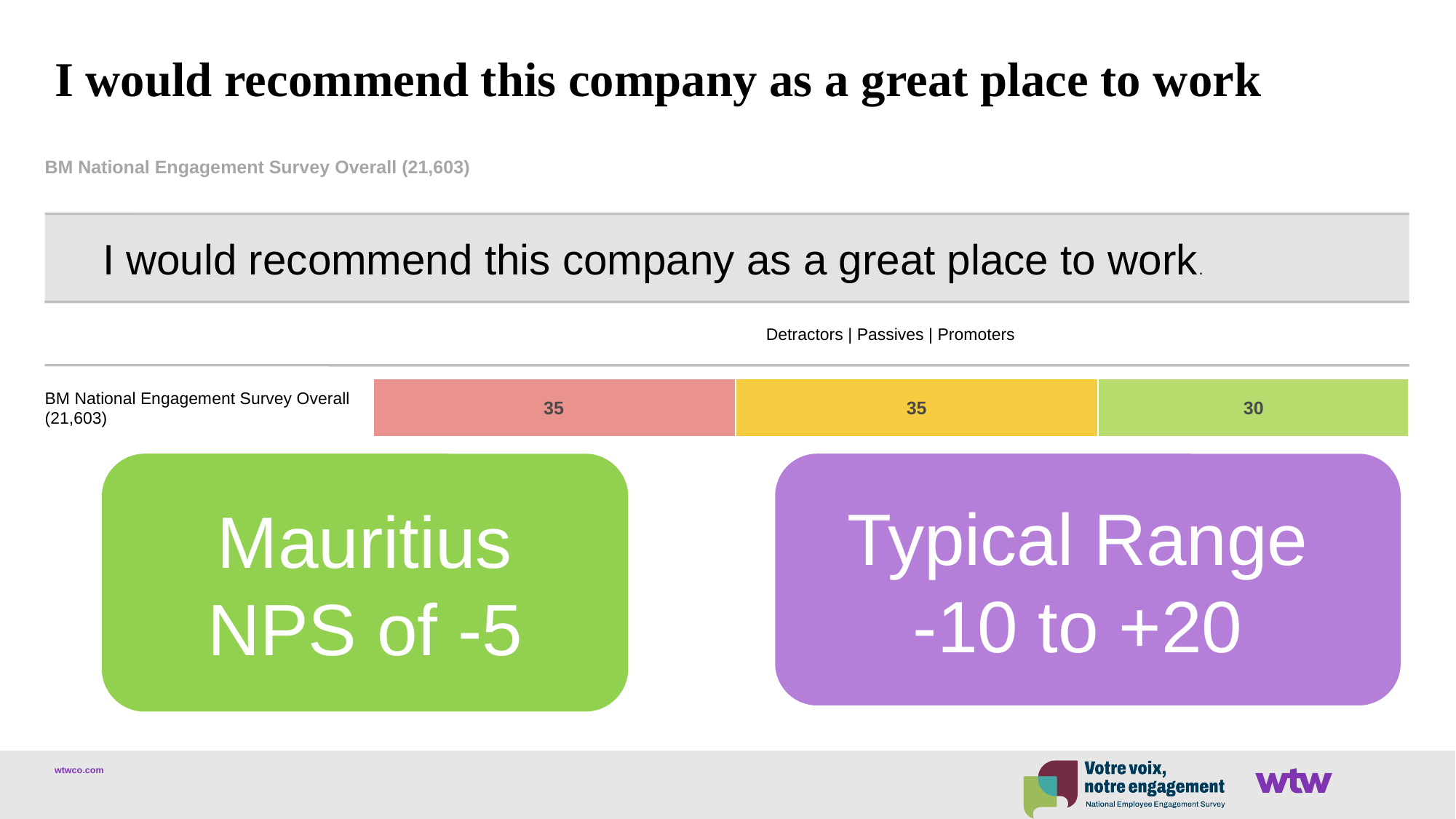
What is the value for Promoters in the stacked bar? 30 What kind of chart is shown on the slide? Stacked bar chart How many segments make up the stacked bar? 3 What colour is the Promoters segment of the bar? Green What is the value for Detractors in the stacked bar? 35 What is the difference between the Detractors value and the Promoters value? 5 What is the total of the stacked bar for BM National Engagement Survey Overall (21,603)? 100 Which is larger, the Passives value or the Promoters value? Passives How many series does the legend list? 3 What is the value for Passives in the stacked bar? 35 Which segment of the stacked bar has the lowest value? Promoters What is the label of the row shown in the bar chart? BM National Engagement Survey Overall (21,603)